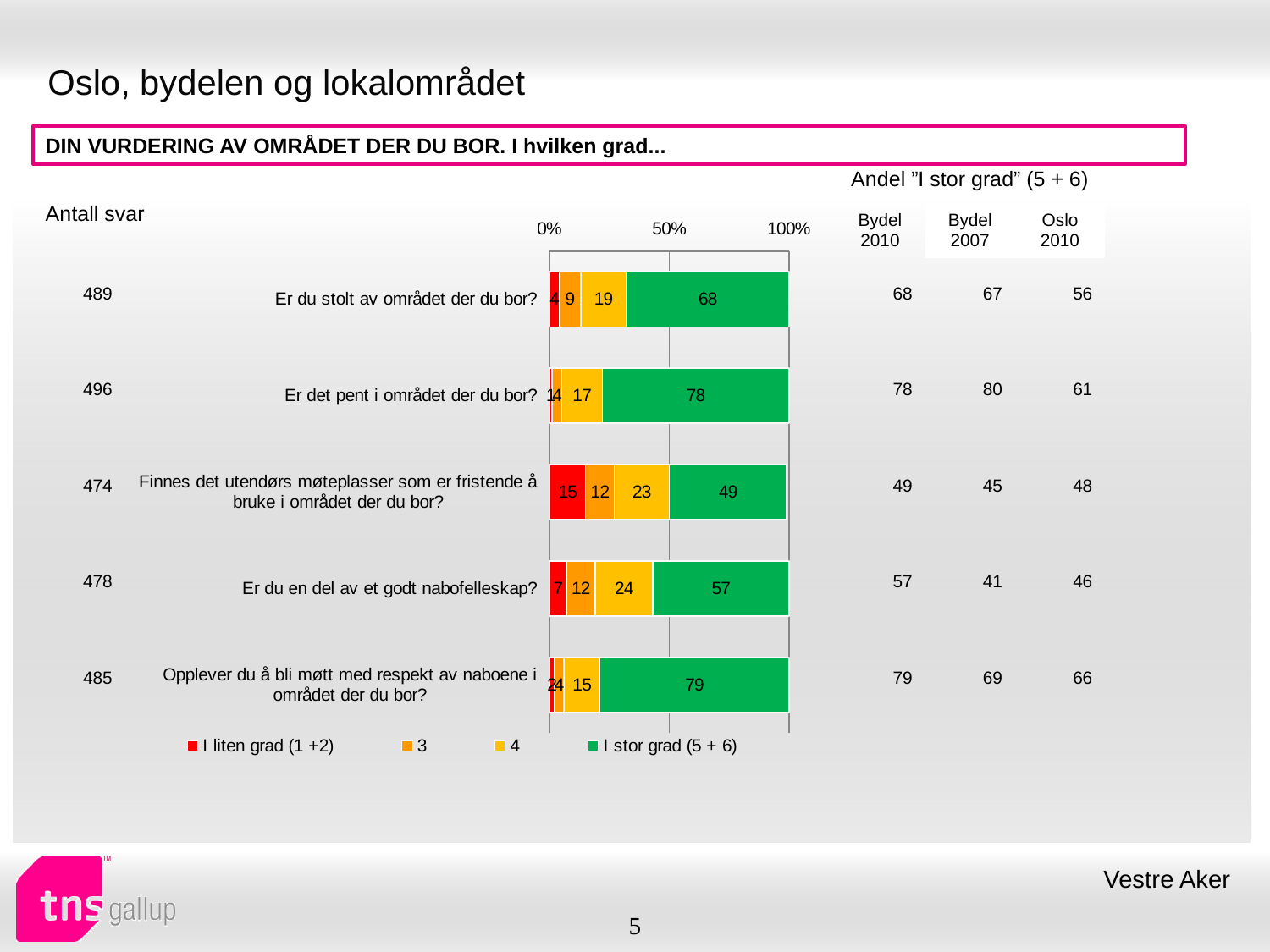
What is the 'I stor grad (5 + 6)' value for 'Er du stolt av området der du bor?' 68 What is the 'I stor grad (5 + 6)' value for 'Opplever du å bli møtt med respekt av naboene i området der du bor?' 79 What is the difference between the 'I stor grad (5 + 6)' values for 'Er det pent i området der du bor?' and 'Er du en del av et godt nabofelleskap?' 21 Which is larger: the '4' value for 'Er du en del av et godt nabofelleskap?' or the '4' value for 'Er du stolt av området der du bor?' Er du en del av et godt nabofelleskap? What is the 'I liten grad (1 +2)' value for 'Finnes det utendørs møteplasser som er fristende å bruke i området der du bor?' 15 Which series in the legend is shown in green? I stor grad (5 + 6) How many series does the chart legend list? 4 Which question has the lowest 'I stor grad (5 + 6)' value? Finnes det utendørs møteplasser som er fristende å bruke i området der du bor? Which question has the highest 'I stor grad (5 + 6)' value? Opplever du å bli møtt med respekt av naboene i området der du bor? What is the '4' value for 'Finnes det utendørs møteplasser som er fristende å bruke i området der du bor?' 23 What type of chart is shown on the slide? bar chart How many question categories are plotted in the chart? 5